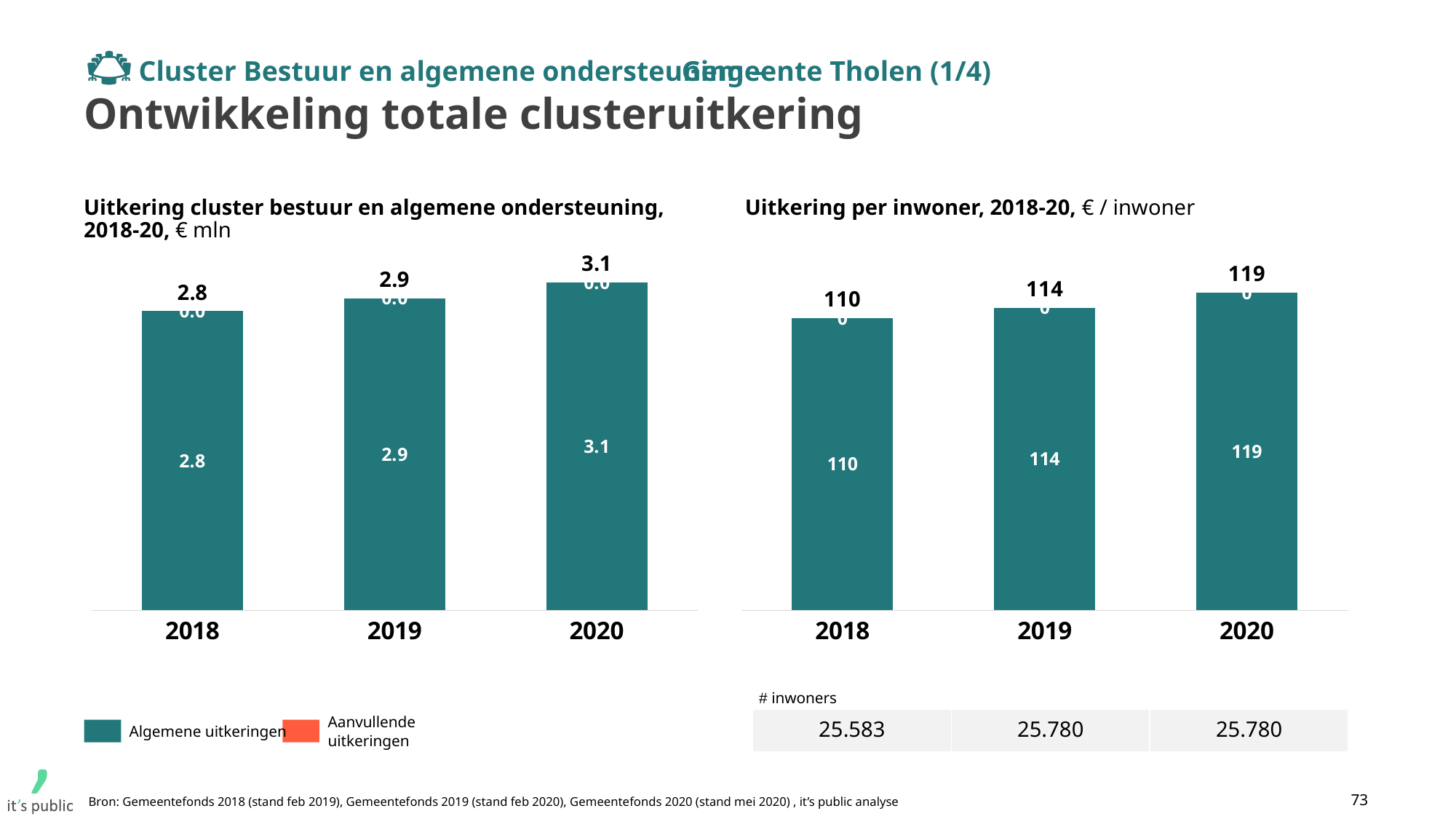
In the right chart (Uitkering per inwoner), what is the value for 2019? 114 What kind of chart is the right chart (Uitkering per inwoner)? Bar chart In the right chart (Uitkering per inwoner), which is larger: the value for 2018 or the value for 2019? 2019 In the right chart (Uitkering per inwoner), which year has the highest value? 2020 In the left chart (Uitkering cluster bestuur en algemene ondersteuning), which year has the lowest total? 2018 In the right chart (Uitkering per inwoner), do the values rise or fall from 2018 to 2020? Rise In the left chart (Uitkering cluster bestuur en algemene ondersteuning), what is the difference between the 2020 and 2019 totals? 0.2 In the right chart (Uitkering per inwoner), what is the difference between the 2020 and 2018 values? 9 How many years are shown on the x axis of the left chart (Uitkering cluster bestuur en algemene ondersteuning)? 3 How many series does the legend of the left chart list? 2 In the left chart (Uitkering cluster bestuur en algemene ondersteuning), what is the value of Algemene uitkeringen for 2018? 2.8 In the left chart (Uitkering cluster bestuur en algemene ondersteuning), what is the total value for 2020? 3.1